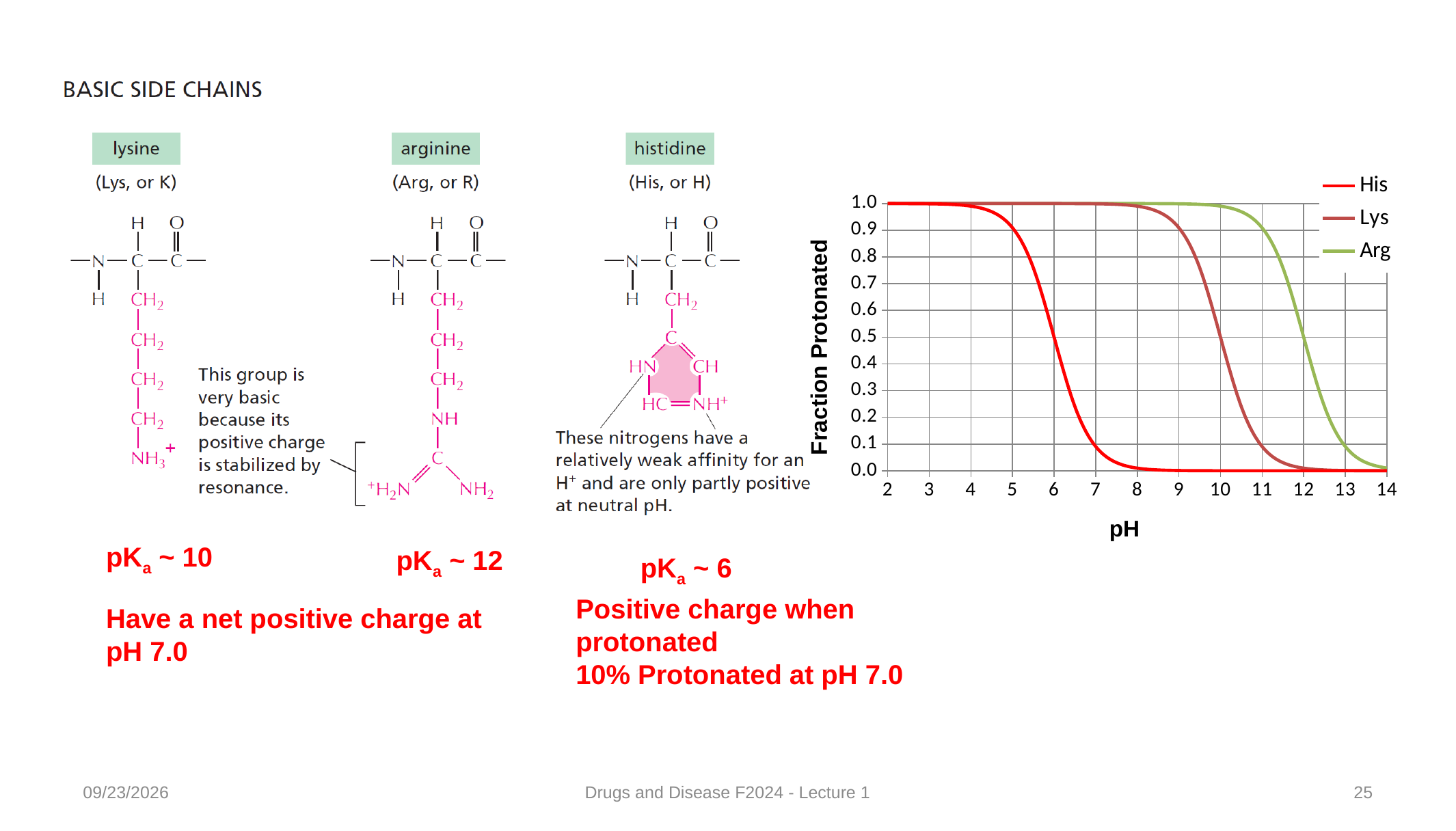
In the Fraction Protonated chart, is the value for His at pH 8 greater or less than 0.1? less How many series does the legend of the Fraction Protonated chart list? 3 In the Fraction Protonated chart, at pH 10, which series has the higher fraction protonated, Lys or Arg? Arg In the Fraction Protonated chart, is the value for Lys at pH 12 greater or less than 0.1? less In the Fraction Protonated chart, is the value for Arg at pH 10 greater or less than 0.9? greater What kind of chart is shown on the right side of the slide? line chart In the Fraction Protonated chart, which series drops to a fraction protonated of 0.5 at the lowest pH? His What are the three series named in the legend of the Fraction Protonated chart? His, Lys, Arg In the Fraction Protonated chart, at pH 6, which series has the higher fraction protonated, His or Lys? Lys In the Fraction Protonated chart, do the curves rise or fall as pH increases? fall What is the label of the x axis of the Fraction Protonated chart? pH